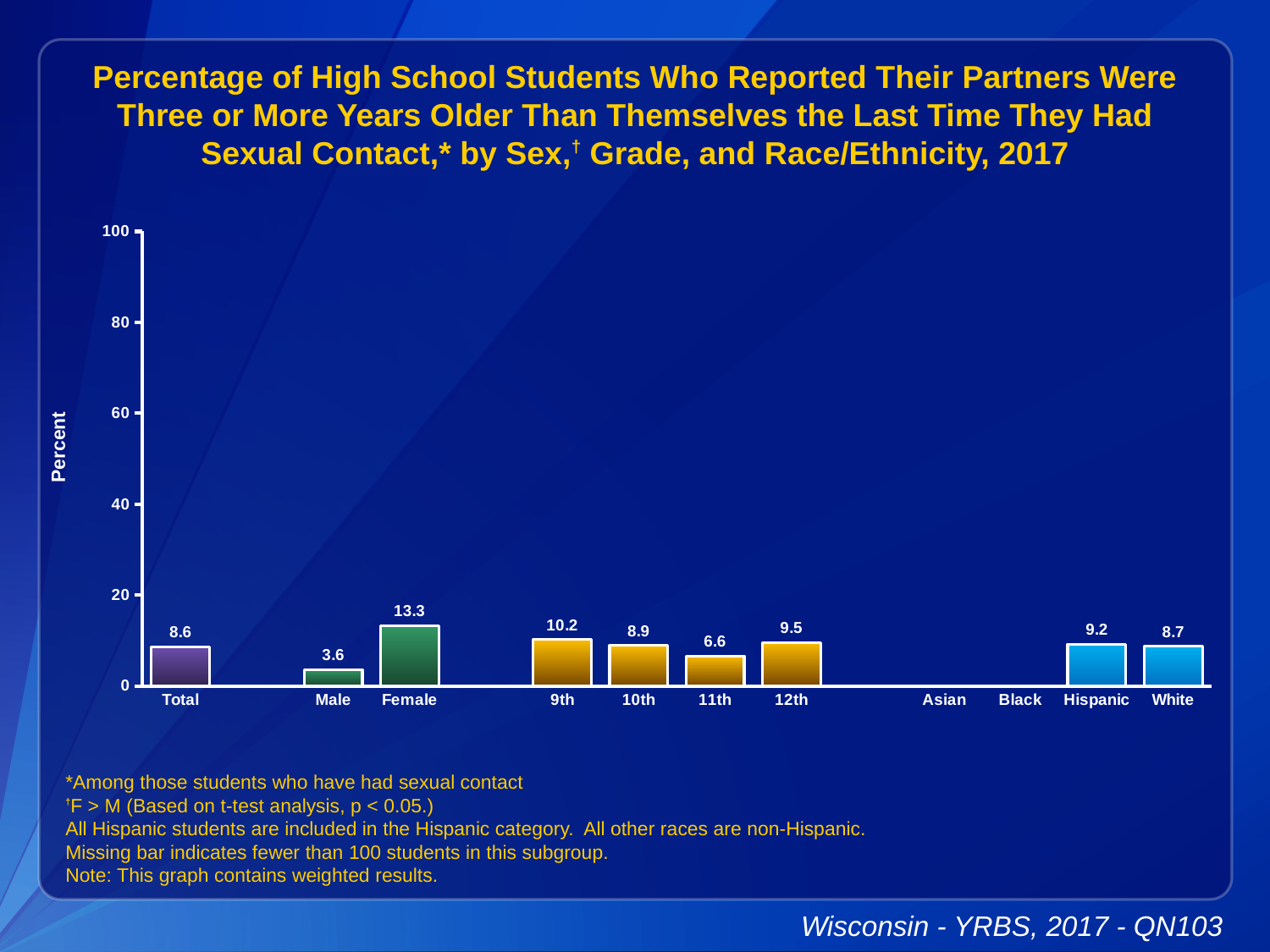
What is the label on the y axis? Percent What is the value for Hispanic? 9.2 What is the difference between the Female and Male values? 9.7 Which is larger, the value for 9th grade or 12th grade? 9th What kind of chart is this? bar chart What is the value for 11th grade? 6.6 What is the value for Male? 3.6 Which category has the highest value? Female How many categories have a plotted bar? 9 Is the value for Total greater or less than 20? less Which category with a plotted bar has the lowest value? Male What is the value for Female? 13.3